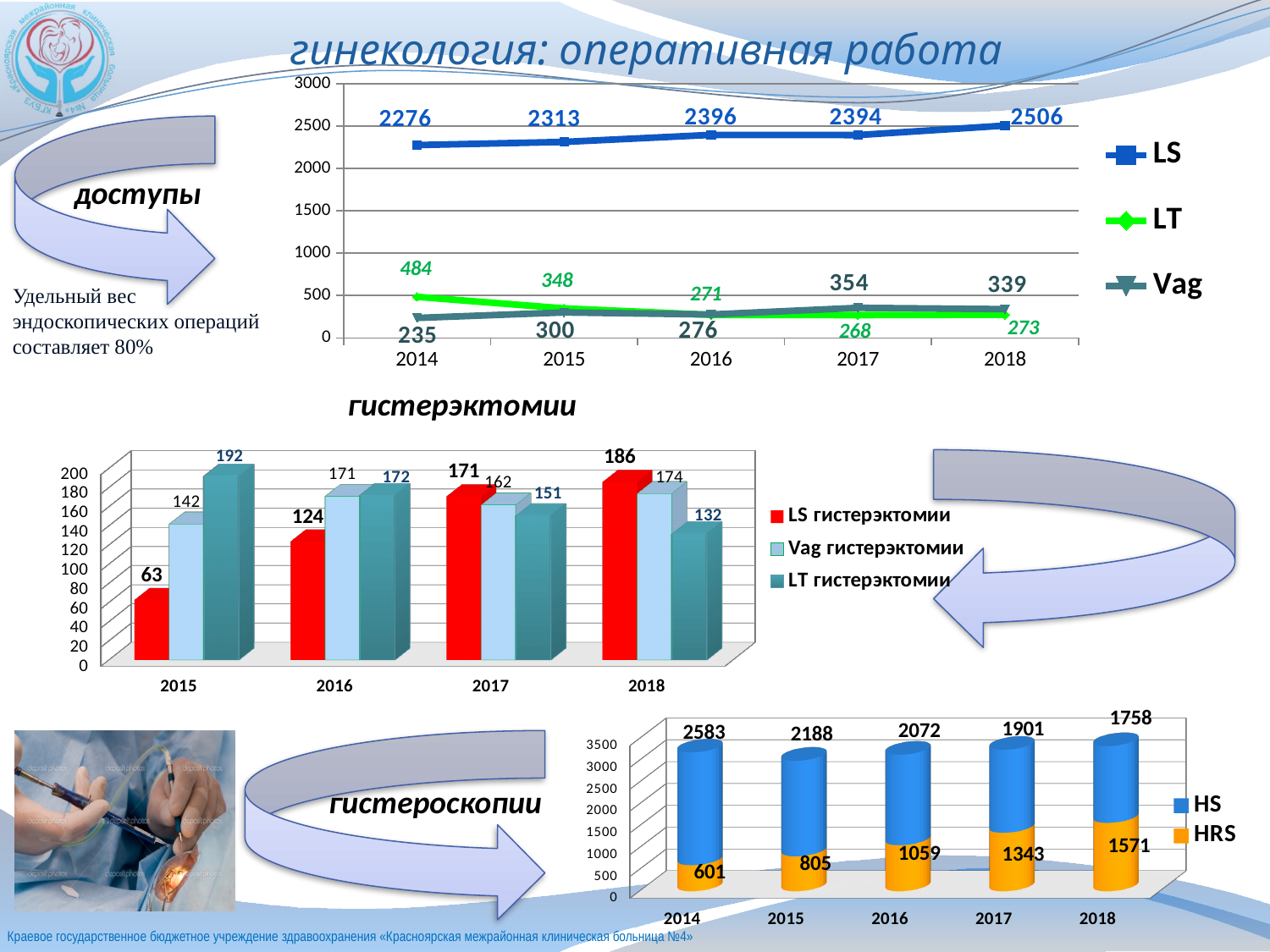
In the top line chart (доступы), what is the difference between the LS values for 2018 and 2014? 230 What kind of chart is the middle chart (гистерэктомии)? bar chart In the middle bar chart (гистерэктомии), which is larger in 2017: LS гистерэктомии or Vag гистерэктомии? LS гистерэктомии In the bottom chart (гистероскопии), what is the HRS value for 2017? 1343 In the bottom chart (гистероскопии), what is the total of the stacked bar for 2014 (HS plus HRS)? 3184 In the top line chart (доступы), what is the LT value for 2014? 484 In the top line chart (доступы), how many series does the legend list? 3 In the middle bar chart (гистерэктомии), what is the LS гистерэктомии value for 2015? 63 In the top line chart (доступы), what is the LS value for 2018? 2506 In the top line chart (доступы), which year has the highest Vag value? 2017 In the middle bar chart (гистерэктомии), which year has the lowest LT гистерэктомии value? 2018 In the top line chart (доступы), does the LT series rise or fall from 2014 to 2016? fall